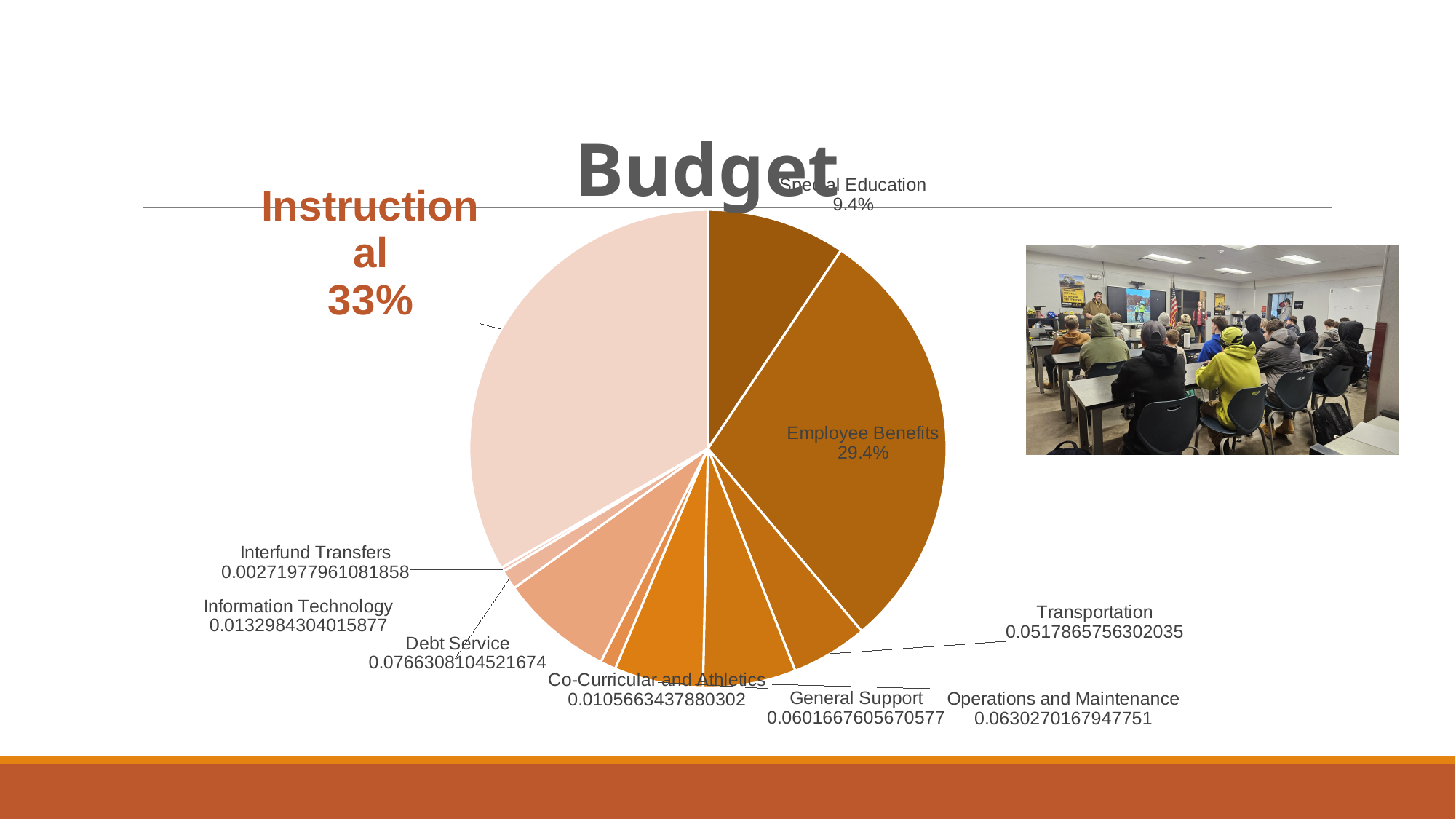
Which is larger, the Employee Benefits slice or the Special Education slice? Employee Benefits What share of the budget is Instructional? 33% How many slices does the pie chart have? 10 Which category has the smallest slice of the pie? Interfund Transfers What kind of chart is shown on the slide? Pie chart What value is shown for Debt Service? 0.0766308104521674 What value is shown for Interfund Transfers? 0.00271977961081858 What is the title of the chart? Budget What share of the budget is Special Education? 9.4% What share of the budget is Employee Benefits? 29.4% Which category has the largest slice of the pie? Instructional What is the difference between the Instructional share and the Employee Benefits share? 3.6%